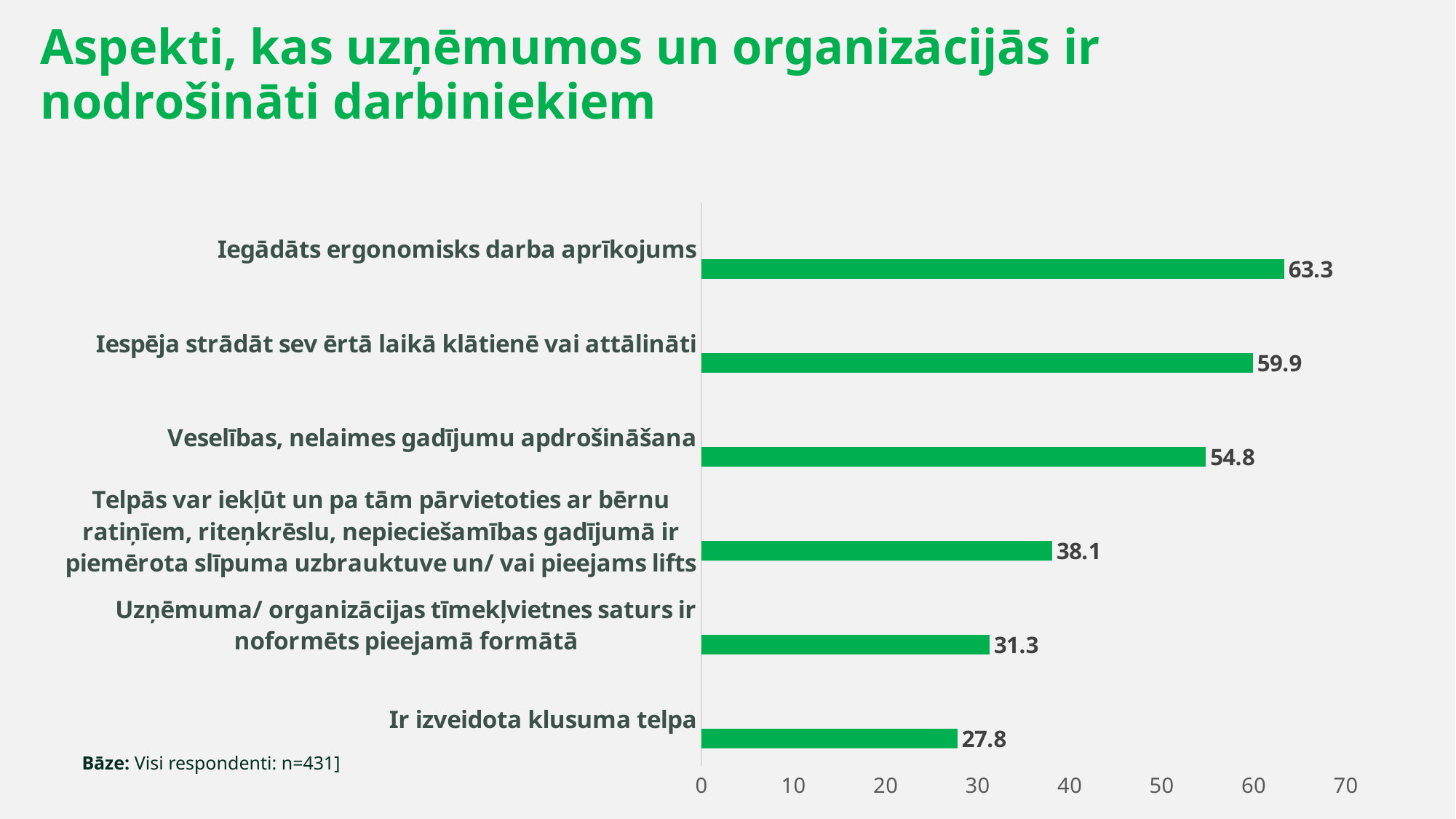
What is the difference between the values for "Iegādāts ergonomisks darba aprīkojums" and "Iespēja strādāt sev ērtā laikā klātienē vai attālināti"? 3.4 What is the value for "Veselības, nelaimes gadījumu apdrošināšana"? 54.8 Which is larger: the value for "Uzņēmuma/ organizācijas tīmekļvietnes saturs ir noformēts pieejamā formātā" or the value for "Ir izveidota klusuma telpa"? Uzņēmuma/ organizācijas tīmekļvietnes saturs ir noformēts pieejamā formātā Which category has the lowest value? Ir izveidota klusuma telpa Is the value for "Veselības, nelaimes gadījumu apdrošināšana" greater or less than 50? greater What is the maximum value shown on the horizontal axis? 70 What is the value for "Ir izveidota klusuma telpa"? 27.8 Which category has the highest value? Iegādāts ergonomisks darba aprīkojums What is the base (sample size) stated on the slide? n=431 How many categories are shown in the chart? 6 What is the value for "Iegādāts ergonomisks darba aprīkojums"? 63.3 What kind of chart is shown on the slide? Bar chart